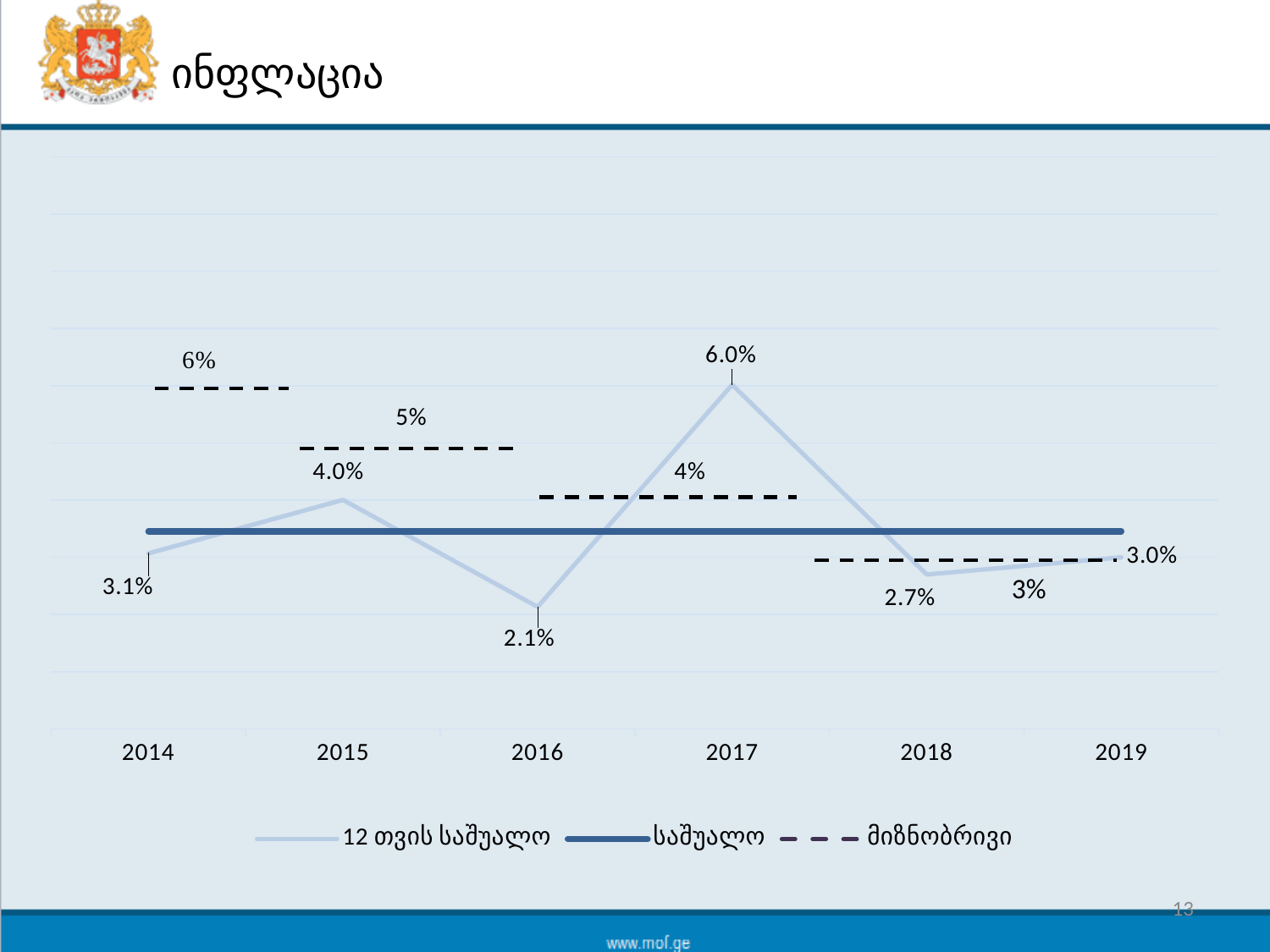
Which year has the lowest value in the 12 თვის საშუალო series? 2016 What is the difference between the 12 თვის საშუალო values for 2017 and 2016? 3.9% What kind of chart is shown on the slide? line chart What is the value of the 12 თვის საშუალო series for 2016? 2.1% What is the მიზნობრივი (target) value shown for 2015? 5% How many series does the legend list? 3 Which is larger, the 12 თვის საშუალო value for 2015 or for 2019? 2015 Which year has the highest value in the 12 თვის საშუალო series? 2017 What is the value of the 12 თვის საშუალო series for 2018? 2.7% How many years are shown on the x axis? 6 What is the value of the 12 თვის საშუალო series for 2014? 3.1% What is the value of the 12 თვის საშუალო series for 2017? 6.0%